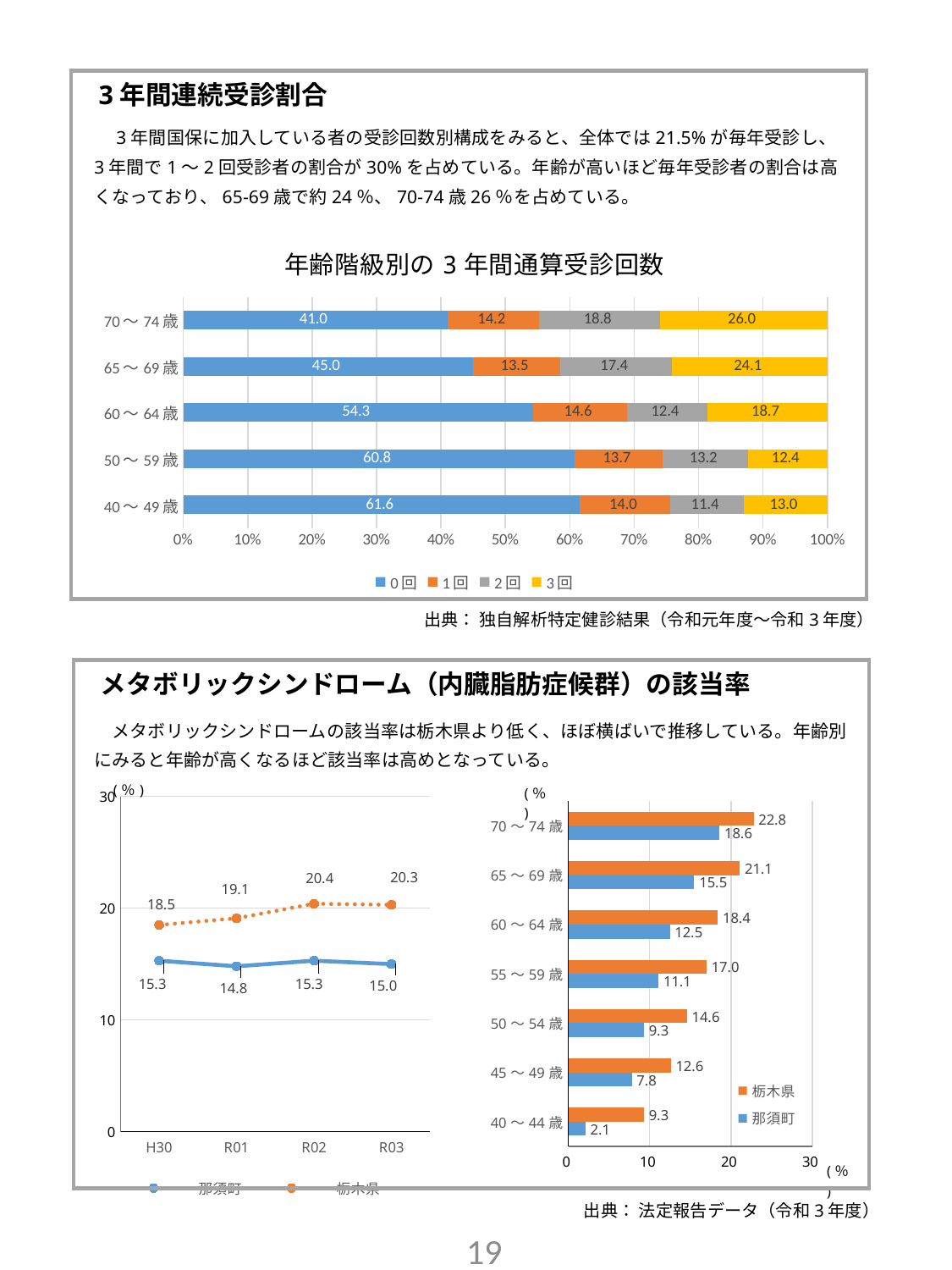
In the bottom-left line chart, what is the value for 栃木県 in R02? 20.4 In the chart titled 年齢階級別の 3 年間通算受診回数, which age group has the highest 3回 value? 70～74歳 In the chart titled 年齢階級別の 3 年間通算受診回数, how many series does the legend list? 4 In the chart titled 年齢階級別の 3 年間通算受診回数, what is the difference between the 0回 values for 40～49歳 and 70～74歳? 20.6 In the chart titled 年齢階級別の 3 年間通算受診回数, what kind of chart is it? Stacked bar chart In the bottom-left line chart, what is the value for 那須町 in R01? 14.8 In the chart titled 年齢階級別の 3 年間通算受診回数, what is the value of the 3回 segment for 70～74歳? 26.0 In the bottom-left line chart, what is the difference between 栃木県 and 那須町 in H30? 3.2 In the bottom-right bar chart, which age group has the highest 栃木県 value? 70～74歳 In the bottom-right bar chart, how many age groups are shown? 7 In the bottom-right bar chart, what is the value for 那須町 in the 40～44歳 group? 2.1 In the chart titled 年齢階級別の 3 年間通算受診回数, what is the value of the 0回 segment for 40～49歳? 61.6